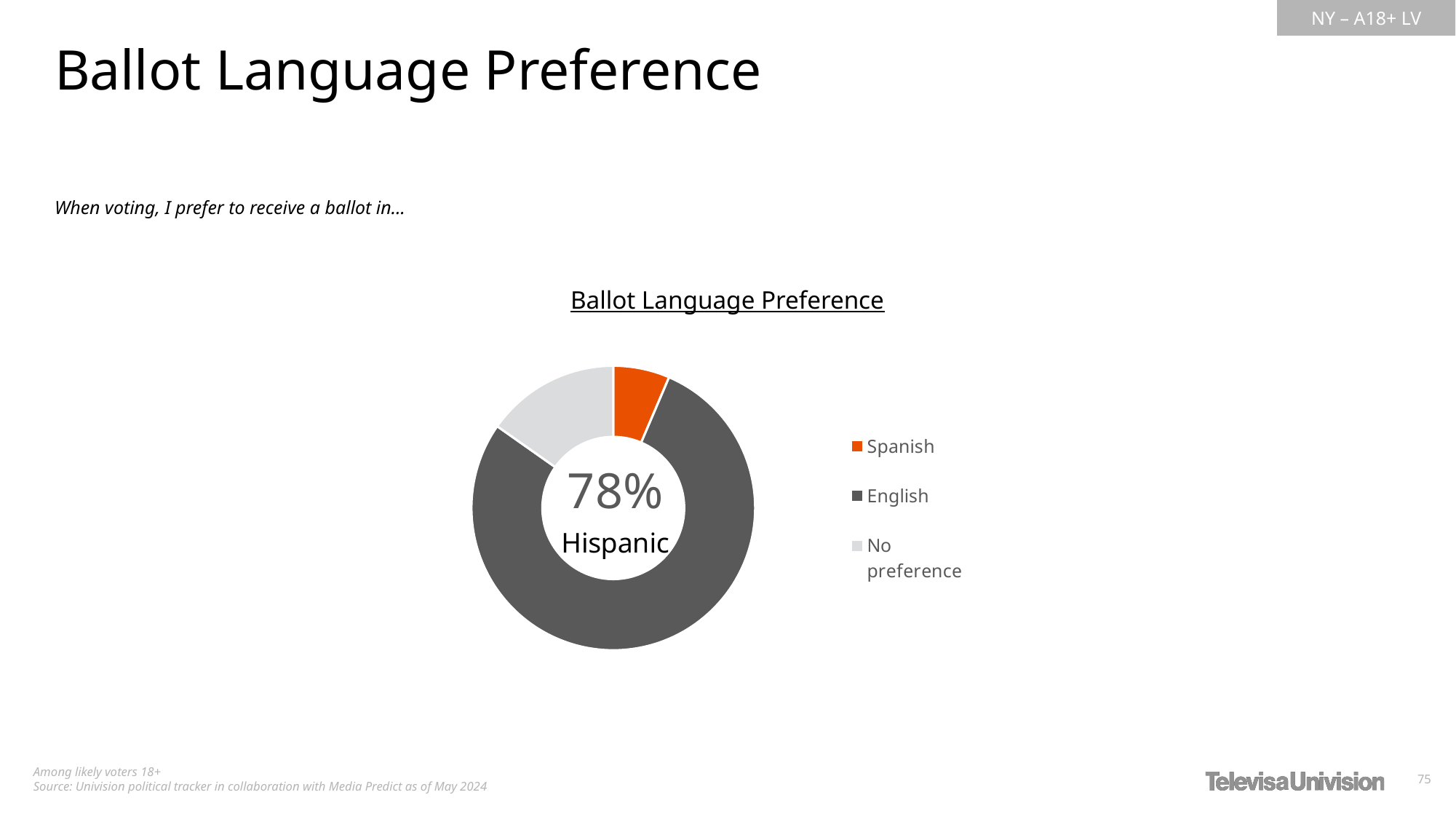
Which slice is larger in the Ballot Language Preference chart, Spanish or No preference? No preference How many entries does the legend of the Ballot Language Preference chart list? 3 Which category has the smallest slice in the Ballot Language Preference chart? Spanish Which category has the largest slice in the Ballot Language Preference chart? English What kind of chart is shown on the slide? Donut (pie) chart How many categories does the Ballot Language Preference chart show? 3 What colour represents Spanish in the Ballot Language Preference chart? Orange What percentage is printed in the center of the donut chart? 78% Which slice is larger in the Ballot Language Preference chart, English or No preference? English